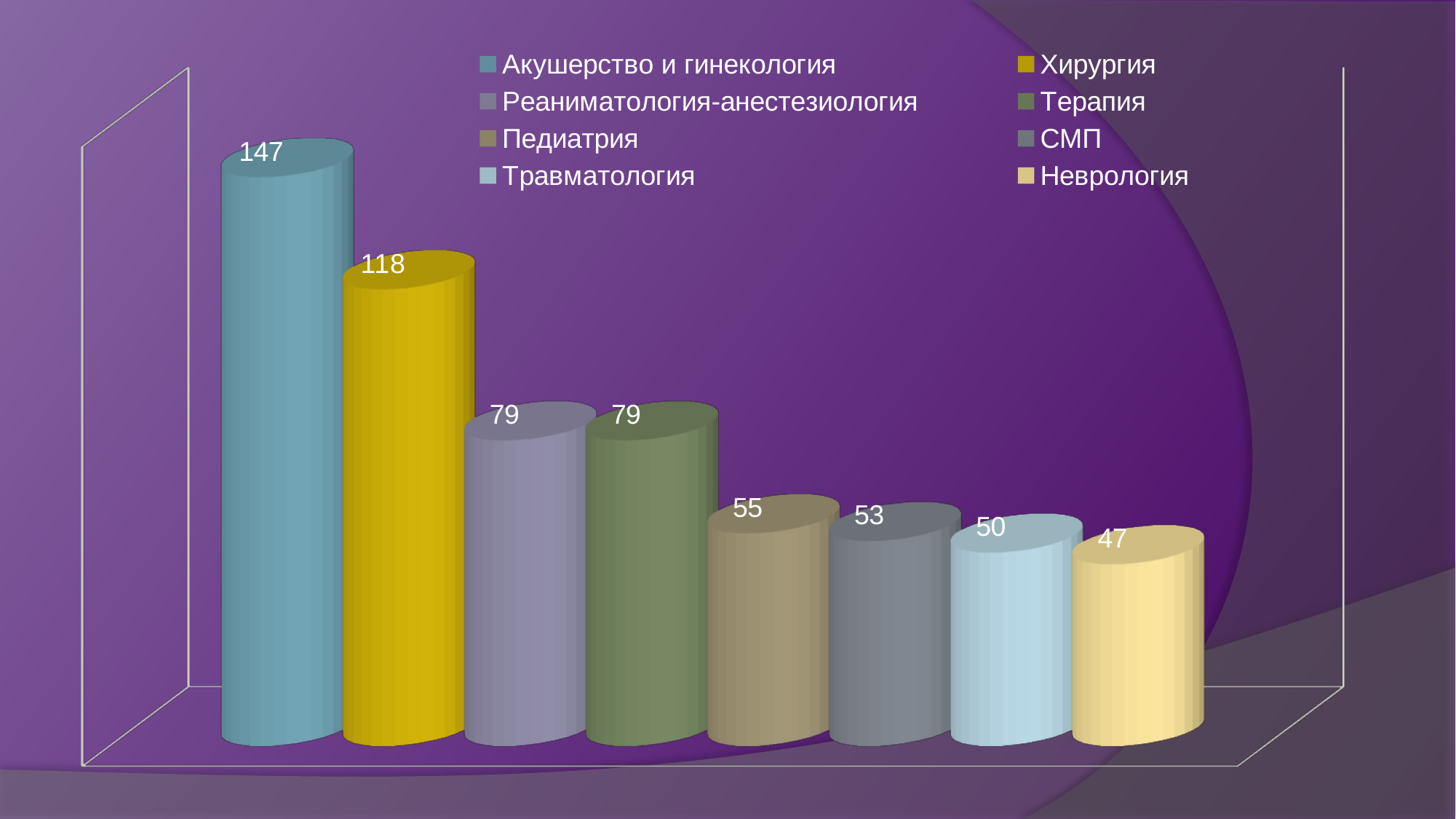
What is the difference between the values for Акушерство и гинекология and Хирургия? 29 Which category has the lowest value? Неврология What kind of chart is shown on the slide? Bar chart What is the value for Хирургия? 118 How many series does the legend list? 8 Do the values rise or fall from left to right across the bars? Fall Which is larger, the value for СМП or the value for Травматология? СМП Which category has the highest value? Акушерство и гинекология What is the difference between the values for Терапия and Травматология? 29 What is the value for Неврология? 47 What is the value for Педиатрия? 55 What is the value for Акушерство и гинекология? 147